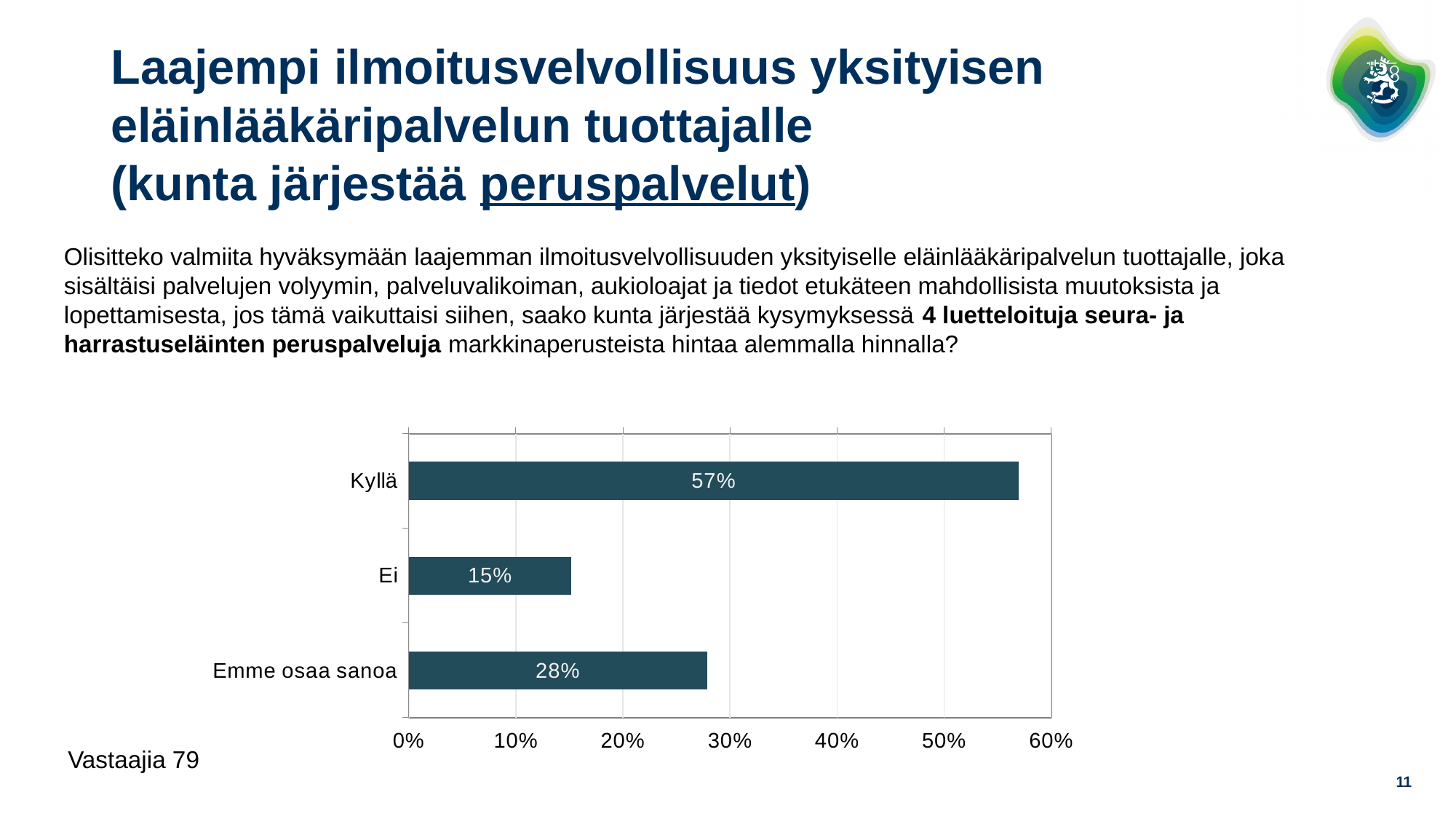
What kind of chart is shown on the slide? bar chart What is the value for Emme osaa sanoa? 28% What is the maximum value shown on the x axis of the chart? 60% Is the value for Kyllä greater or less than 50%? greater What is the value for Ei? 15% How many categories are shown in the chart? 3 Which category has the highest value? Kyllä What is the difference between the values for Emme osaa sanoa and Ei? 13% Which category has the lowest value? Ei What is the difference between the values for Kyllä and Ei? 42% Which is larger, the value for Ei or the value for Emme osaa sanoa? Emme osaa sanoa What is the value for Kyllä? 57%